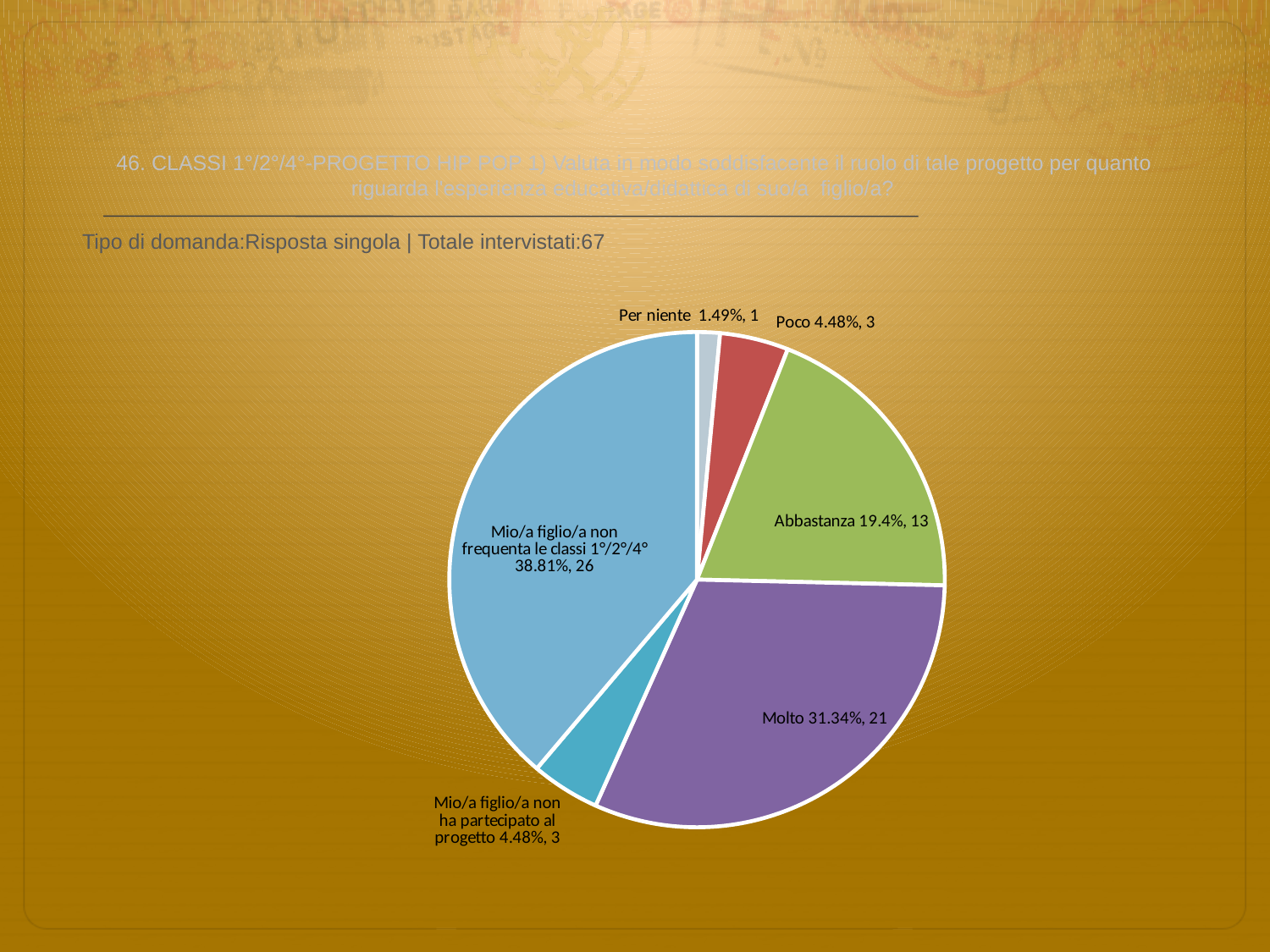
What share of the pie does 'Mio/a figlio/a non ha partecipato al progetto' represent? 4.48% What percentage is shown for 'Per niente'? 1.49% What is the total number of respondents stated on the slide? 67 How many respondents answered 'Abbastanza'? 13 What kind of chart is shown on the slide? pie chart How many slices does the pie chart have? 6 Which category has the largest slice of the pie? Mio/a figlio/a non frequenta le classi 1°/2°/4° Which is larger, the 'Poco' slice or the 'Abbastanza' slice? Abbastanza Which category has the smallest slice of the pie? Per niente What percentage is shown for the 'Molto' slice? 31.34% What is the difference in count between 'Molto' and 'Abbastanza'? 8 How many respondents are in the 'Mio/a figlio/a non frequenta le classi 1°/2°/4°' slice? 26